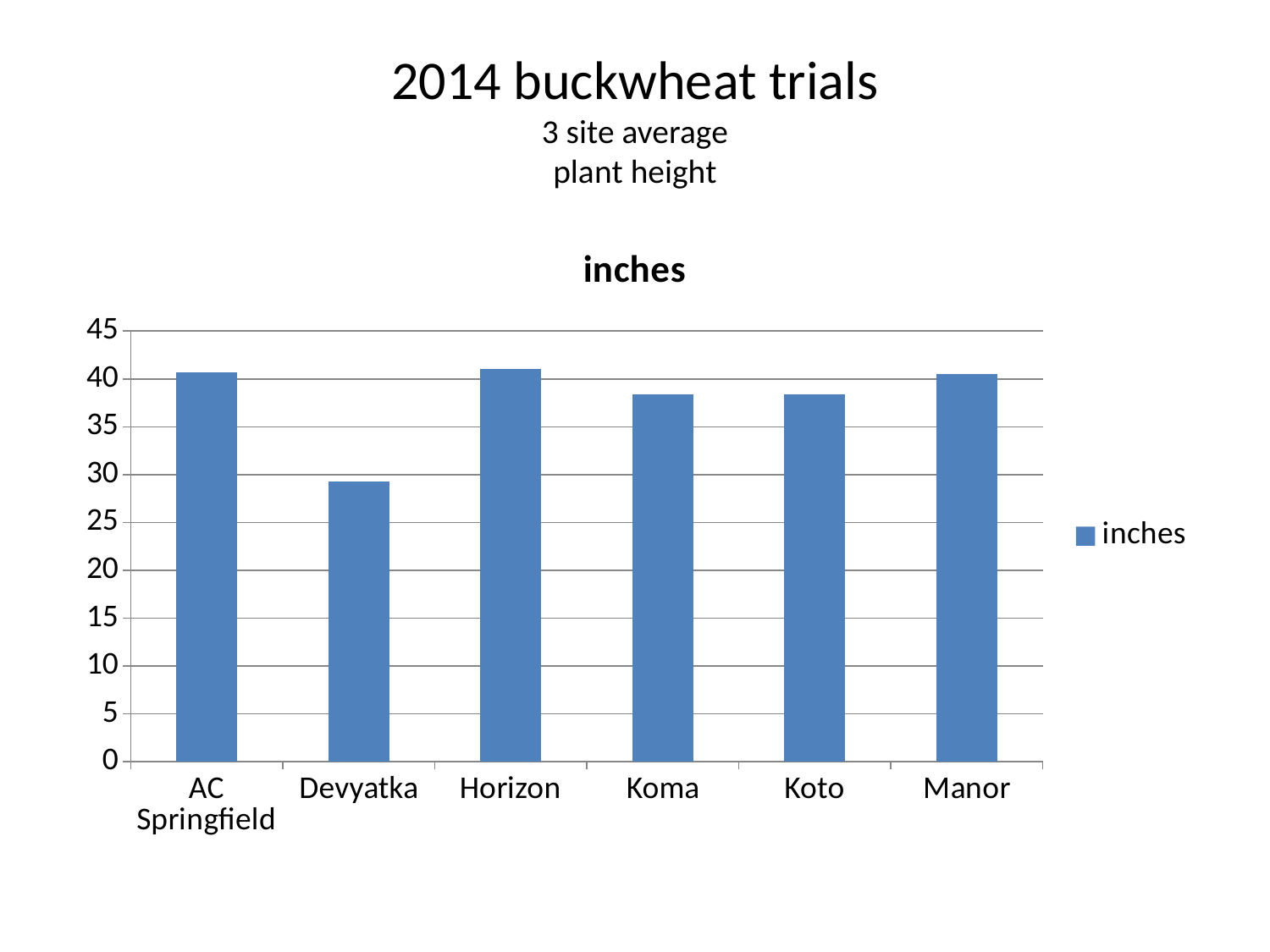
What is the title shown above the chart? inches Is the value for Horizon greater or less than 40? greater Which variety has the lowest plant height? Devyatka How many buckwheat varieties are plotted on the chart? 6 Is the value for Koto greater or less than 35? greater What kind of chart is shown on the slide? bar chart Which is larger, the value for Devyatka or the value for Horizon? Horizon How many series does the legend list? 1 Is the value for Koma greater or less than 40? less Which is larger, the value for Koma or the value for Devyatka? Koma